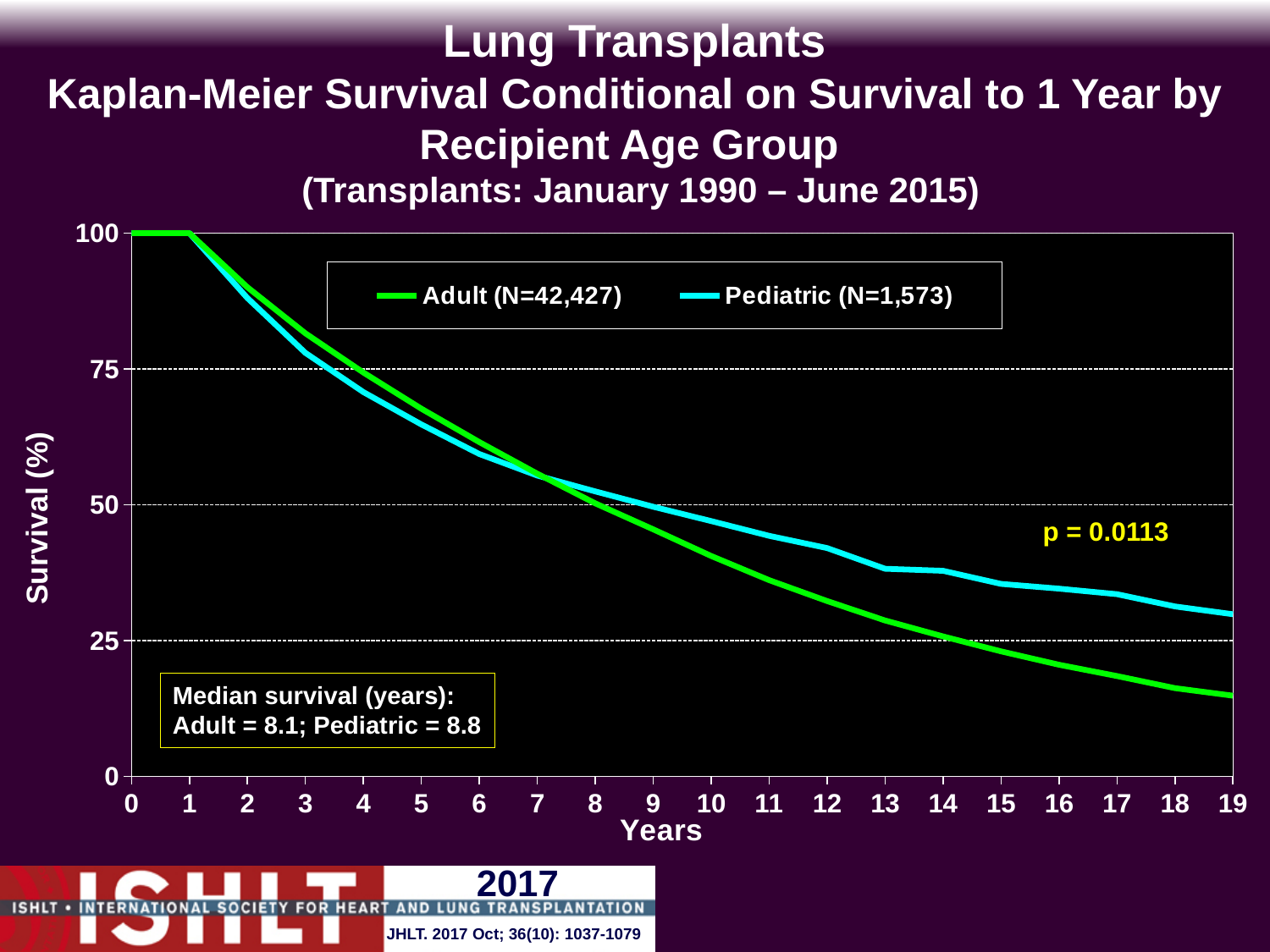
Is the Adult survival value at 10 years greater or less than 50? less Do the survival curves rise or fall as years increase? fall Which group has the higher median survival, Adult or Pediatric? Pediatric What is the difference in median survival (years) between the Pediatric and Adult groups? 0.7 What is the label of the y axis? Survival (%) What kind of chart is shown on the slide? Line chart Is the Adult survival value at 19 years greater or less than 25? less What p-value is shown on the chart? p = 0.0113 What is the median survival in years for the Adult group? 8.1 Is the Pediatric survival value at 19 years greater or less than 25? greater How many series does the legend list? 2 What is the median survival in years for the Pediatric group? 8.8